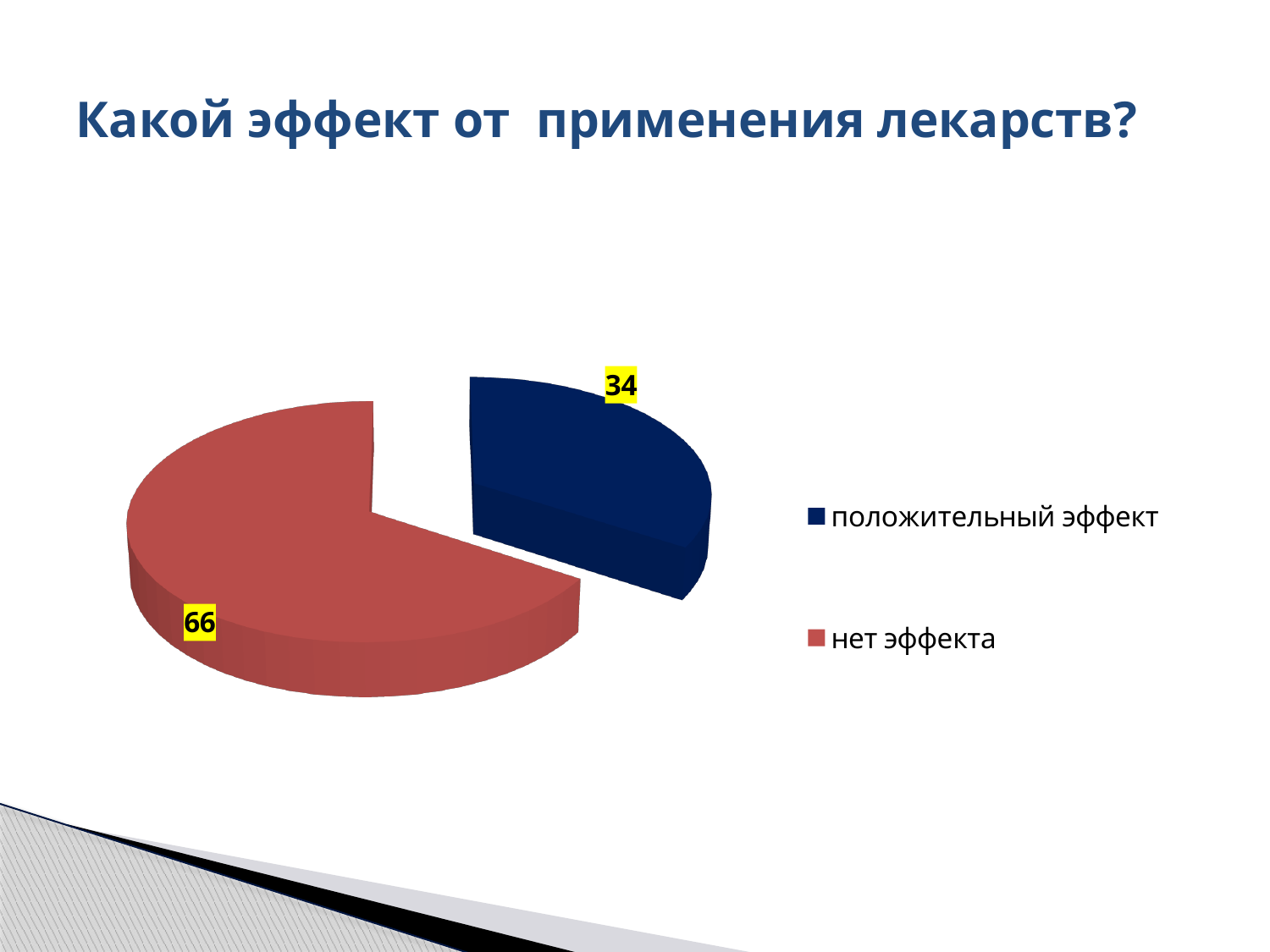
Which is larger: "положительный эффект" or "нет эффекта"? нет эффекта How many entries does the legend list? 2 How many slices does the pie chart have? 2 What is the value for "положительный эффект"? 34 What is the value for "нет эффекта"? 66 What colour is the slice for "положительный эффект"? dark blue What share of the pie does "нет эффекта" represent? 66% Which category has the largest slice? нет эффекта What is the title of the slide? Какой эффект от применения лекарств? Which category has the smallest slice? положительный эффект What is the difference between the values for "нет эффекта" and "положительный эффект"? 32 What kind of chart is shown on the slide? pie chart